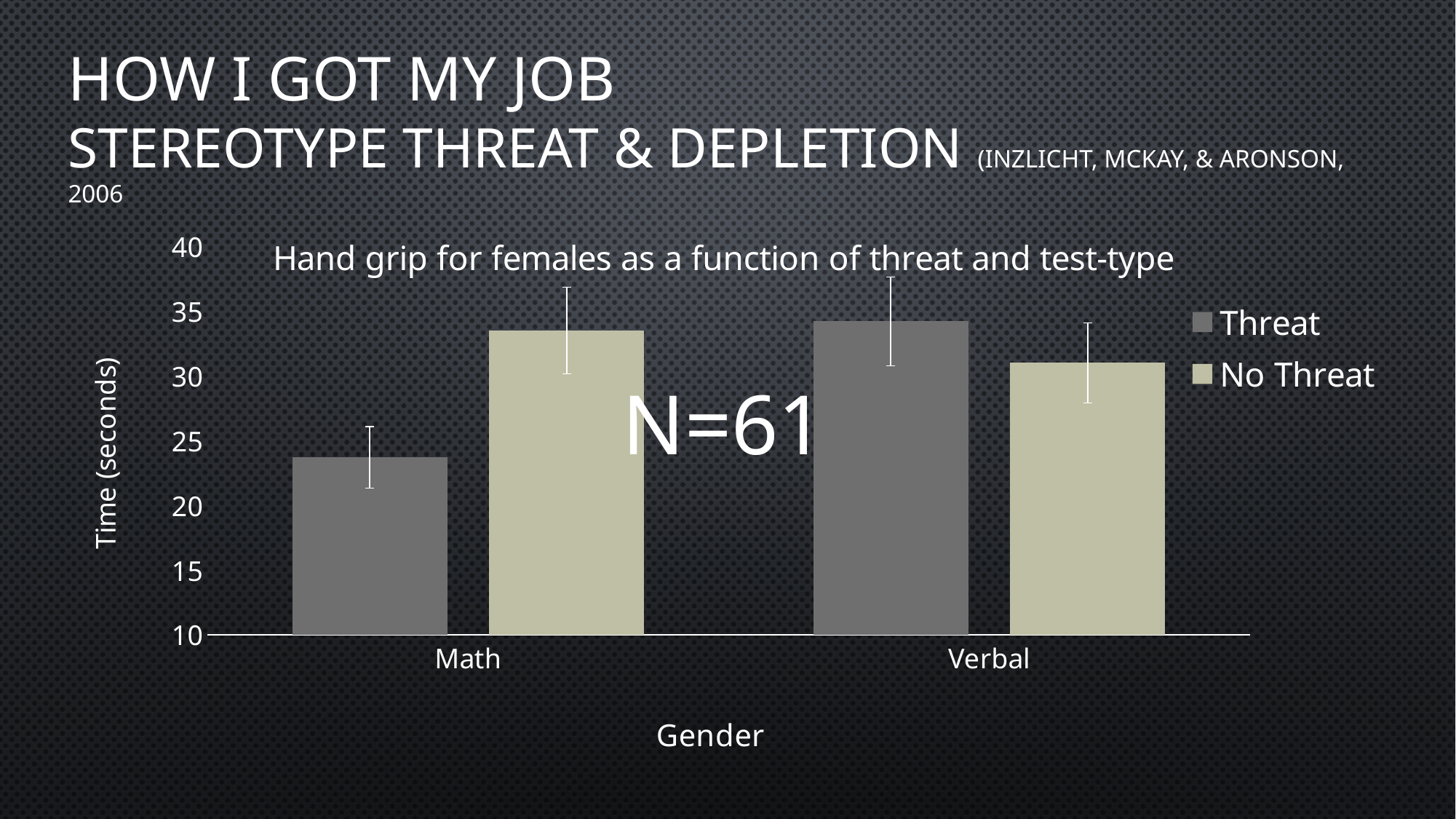
Is the value for No Threat in the Verbal category greater or less than 35? less For the Math category, which is larger: Threat or No Threat? No Threat Which bar is the lowest in the chart? Threat for Math Does the Threat series rise or fall from Math to Verbal? Rise Is the value for No Threat in the Math category greater or less than 30? greater What is the label of the vertical axis of the chart? Time (seconds) For the Verbal category, which is larger: Threat or No Threat? Threat What kind of chart is shown on the slide? Bar chart How many categories are shown on the x axis of the chart? 2 What is the title of the chart? Hand grip for females as a function of threat and test-type Is the value for Threat in the Math category greater or less than 30? less How many series does the chart legend list? 2